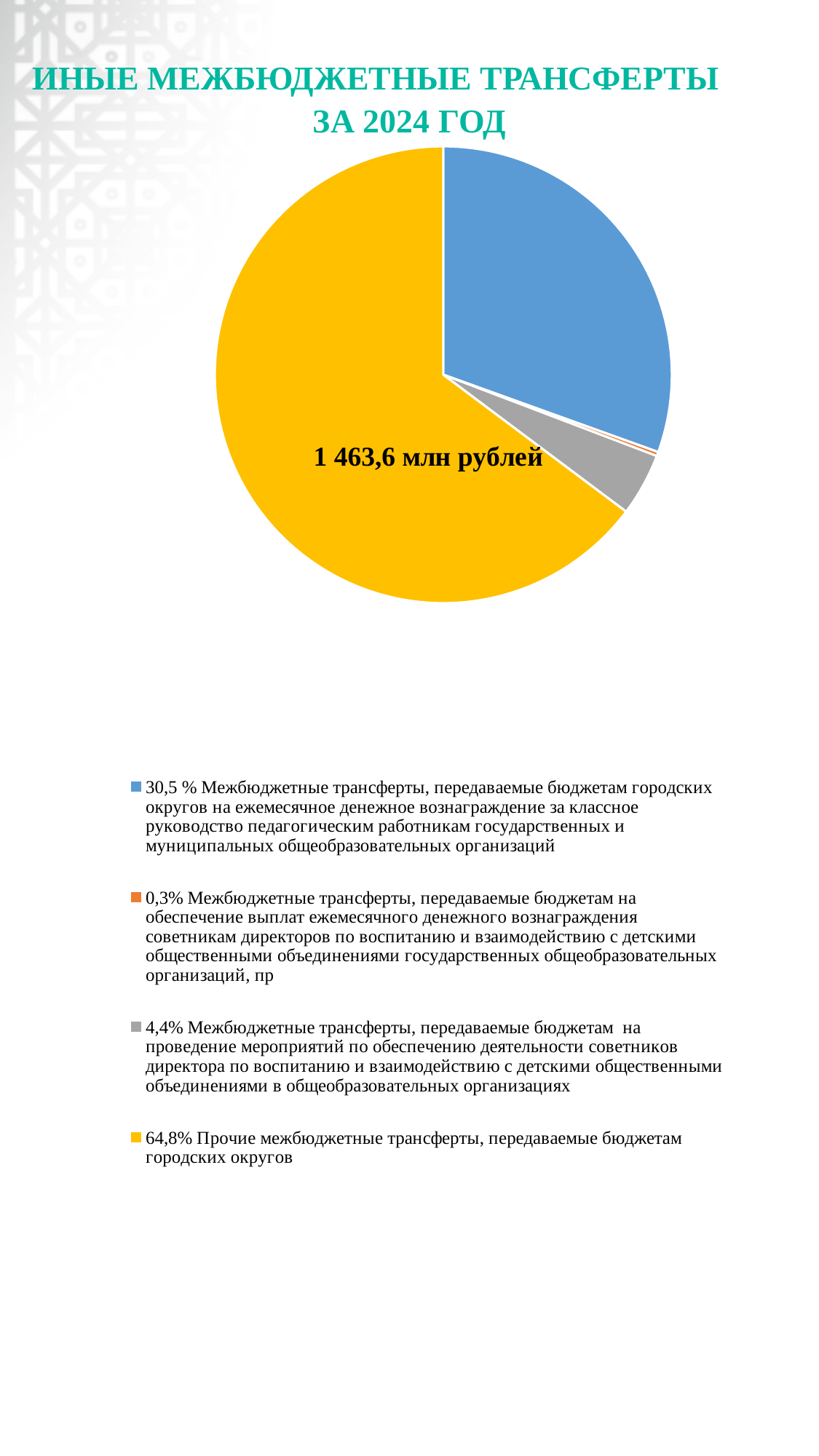
Что больше: доля трансфертов на проведение мероприятий по обеспечению деятельности советников директора (4,4%) или доля трансфертов на выплаты вознаграждения советникам директоров (0,3%)? Доля трансфертов на проведение мероприятий по обеспечению деятельности советников директора (4,4%) Сколько секторов (категорий) содержит круговая диаграмма? 4 Какую долю составляют межбюджетные трансферты на проведение мероприятий по обеспечению деятельности советников директора по воспитанию? 4,4% Какая категория имеет наименьшую долю на диаграмме? Межбюджетные трансферты на обеспечение выплат ежемесячного денежного вознаграждения советникам директоров по воспитанию Какая категория имеет наибольшую долю на диаграмме? Прочие межбюджетные трансферты, передаваемые бюджетам городских округов Какую долю составляют межбюджетные трансферты на обеспечение выплат ежемесячного денежного вознаграждения советникам директоров по воспитанию? 0,3% Каким цветом на диаграмме обозначены прочие межбюджетные трансферты, передаваемые бюджетам городских округов? Жёлтым Какая общая сумма иных межбюджетных трансфертов указана на диаграмме? 1 463,6 млн рублей Какую долю составляют прочие межбюджетные трансферты, передаваемые бюджетам городских округов? 64,8% Какой тип диаграммы показан на слайде? Круговая диаграмма На сколько процентных пунктов доля прочих межбюджетных трансфертов больше доли трансфертов на вознаграждение за классное руководство? 34,3